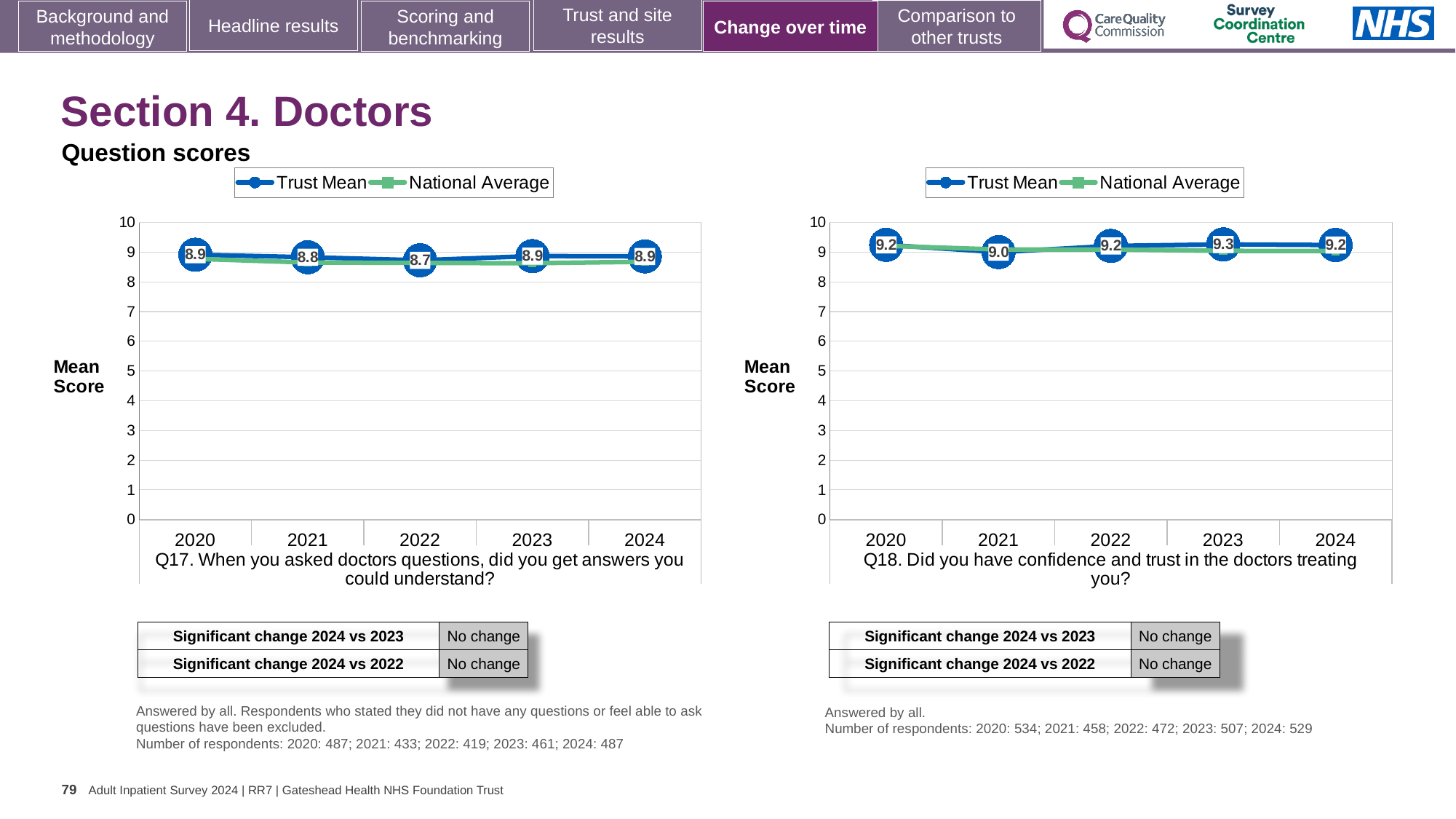
In the Q17 chart on the left, which year has the lowest Trust Mean score? 2022 In the Q17 chart on the left, what is the Trust Mean score for 2022? 8.7 In the Q18 chart on the right, what is the Trust Mean score for 2023? 9.3 In the Q17 chart on the left, is the Trust Mean score higher in 2020 or in 2022? 2020 How many series does the legend of the Q18 chart on the right list? 2 In the Q18 chart on the right, which year has the highest Trust Mean score? 2023 In the Q18 chart on the right, what is the difference between the Trust Mean scores for 2023 and 2021? 0.3 In the Q17 chart on the left, does the Trust Mean score rise or fall from 2020 to 2022? Fall How many years are plotted on the x axis of the Q17 chart on the left? 5 In the Q18 chart on the right, is the National Average value for 2020 greater or less than 8? greater In the Q18 chart on the right, what is the Trust Mean score for 2021? 9.0 What type of chart is used for Q17 on the left? Line chart